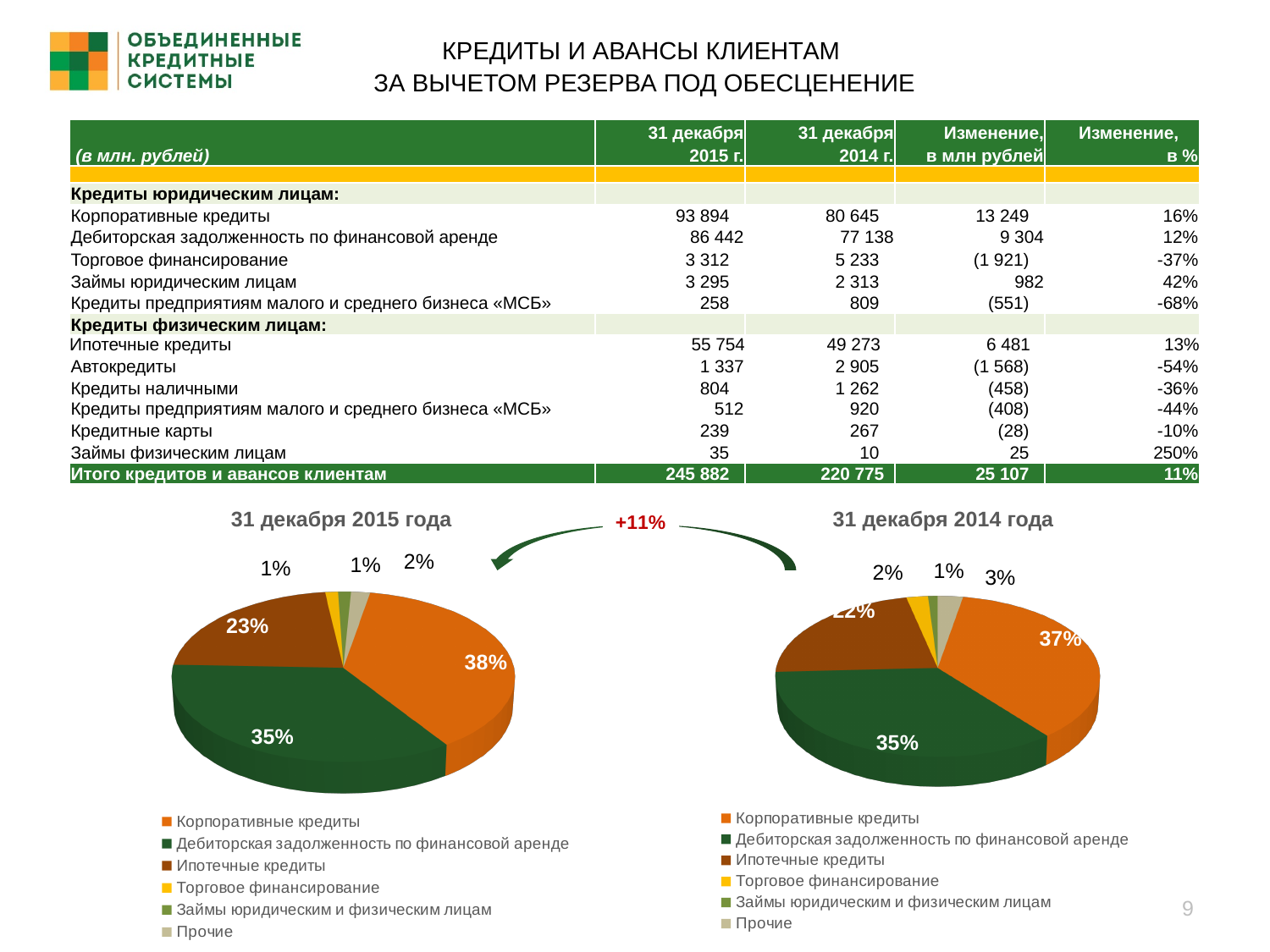
What type of chart is used for "31 декабря 2015 года"? Pie chart In the pie chart titled "31 декабря 2014 года", what share is shown for Корпоративные кредиты? 37% How many entries does the legend of the pie chart titled "31 декабря 2014 года" list? 6 How many slices does the pie chart titled "31 декабря 2015 года" have? 6 In the pie chart titled "31 декабря 2015 года", which category has the largest slice? Корпоративные кредиты In the pie chart titled "31 декабря 2014 года", which is larger: the Торговое финансирование slice or the Прочие slice? Прочие In the pie chart titled "31 декабря 2015 года", what share is shown for Корпоративные кредиты? 38% In the pie chart titled "31 декабря 2015 года", what is the difference in percentage points between the Корпоративные кредиты slice and the Ипотечные кредиты slice? 15 What percentage change is shown on the arrow between the two pie charts? +11% In the pie chart titled "31 декабря 2014 года", what share is shown for Прочие? 3% In the pie chart titled "31 декабря 2015 года", what share is shown for Ипотечные кредиты? 23% In the pie chart titled "31 декабря 2014 года", which category has the largest slice? Корпоративные кредиты